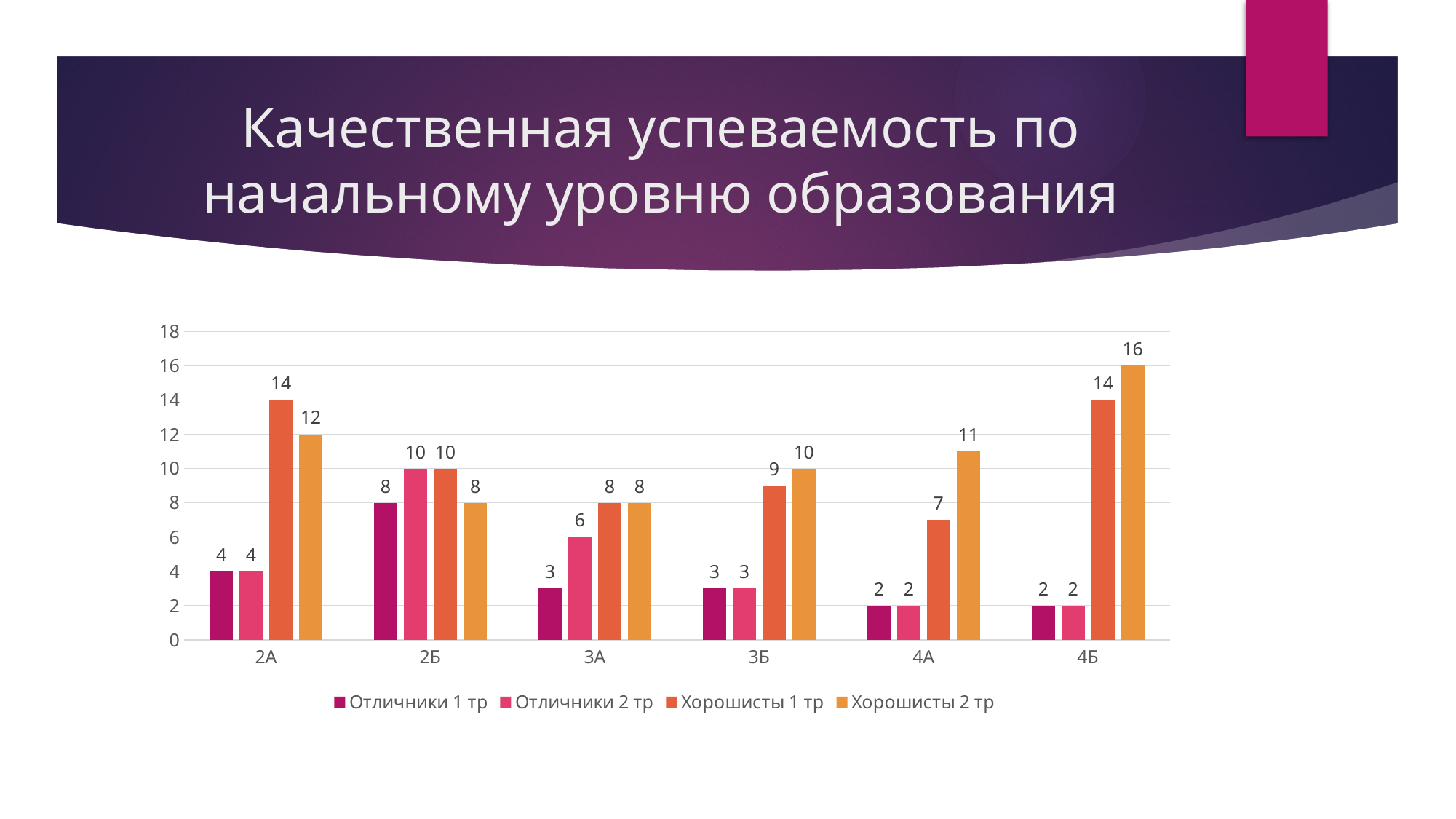
Which class has the highest value for Отличники 1 тр? 2Б Does the value of Хорошисты 2 тр for class 4Б rise or fall compared with class 4А? rise Which class has the lowest value for Хорошисты 1 тр? 4А What is the difference between Хорошисты 2 тр and Хорошисты 1 тр for class 4А? 4 What type of chart is shown on the slide? bar chart For class 2А, which is larger: Хорошисты 1 тр or Хорошисты 2 тр? Хорошисты 1 тр What is the title of the slide containing the chart? Качественная успеваемость по начальному уровню образования What is the value of Отличники 2 тр for class 3А? 6 How many series does the legend list? 4 What is the value of Хорошисты 2 тр for class 4Б? 16 How many classes (categories) are shown on the x axis? 6 What is the value of Хорошисты 1 тр for class 4А? 7